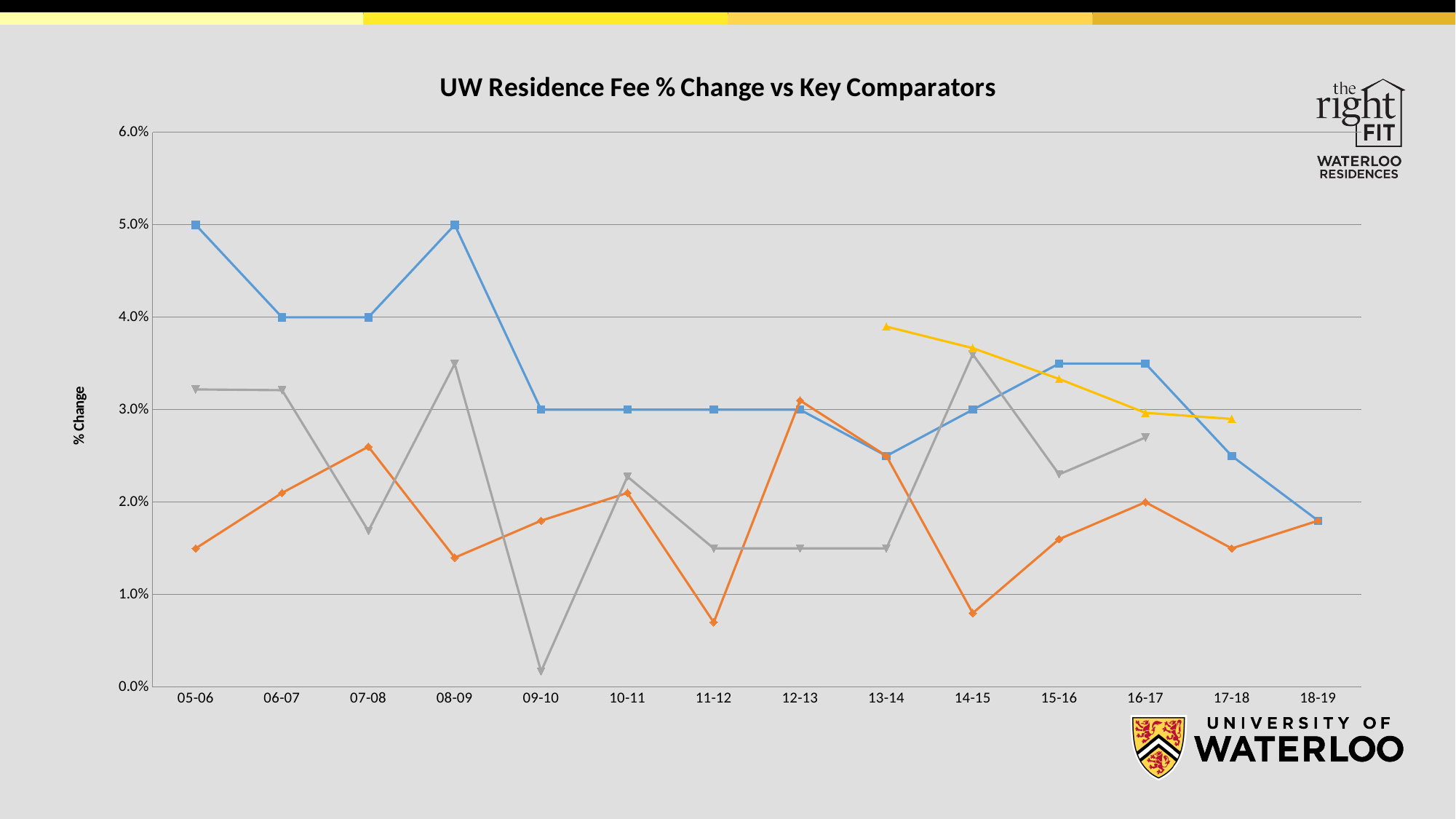
What is the value of the blue line at 05-06? 5.0% What kind of chart is shown on the slide? line chart What is the value of the blue line at 10-11? 3.0% How many academic years are shown along the x axis? 14 What is the title of the chart? UW Residence Fee % Change vs Key Comparators At 08-09, which line has the higher value, the blue line or the orange line? blue line Does the yellow line rise or fall from 13-14 to 17-18? fall Is the value of the yellow line at 13-14 greater or less than 3.0%? greater Is the value of the grey line at 09-10 greater or less than 1.0%? less What is the value of the blue line at 06-07? 4.0% Is the value of the orange line at 11-12 greater or less than 1.0%? less In which year does the grey line reach its lowest value? 09-10